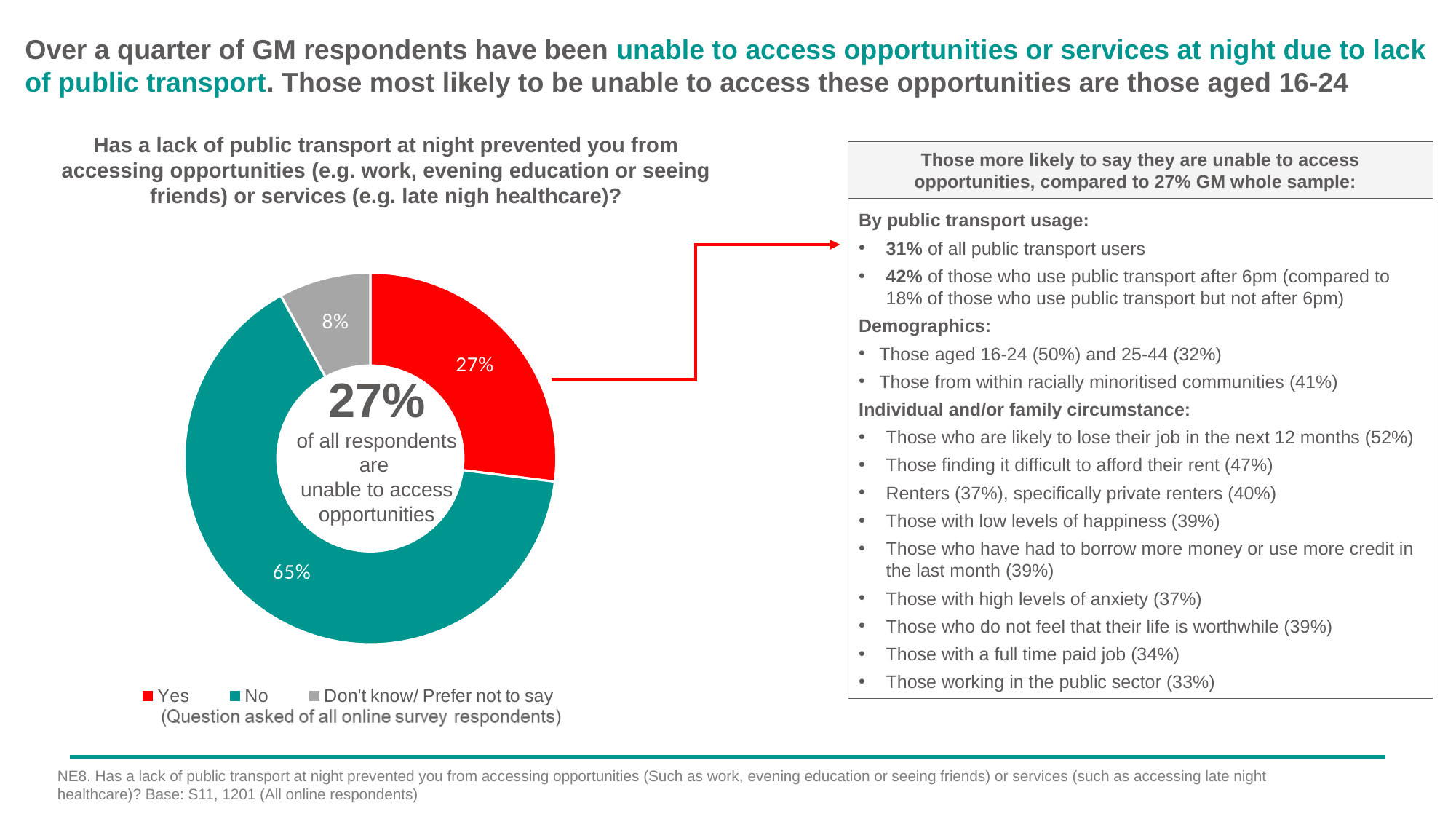
Which response category has the largest share of the chart? No What is the combined share of 'Yes' and 'No' responses? 92% What percentage of respondents answered 'Don't know/ Prefer not to say'? 8% Which is larger, the share for 'Yes' or the share for 'Don't know/ Prefer not to say'? Yes Which response category has the smallest share of the chart? Don't know/ Prefer not to say What kind of chart is shown on the slide? Doughnut (pie) chart What figure is printed in the centre of the doughnut chart? 27% What percentage of respondents answered 'No'? 65% What colour is used for the 'Yes' segment? Red How many categories does the chart show? 3 What is the difference in percentage points between the 'No' and 'Yes' shares? 38 What percentage of respondents answered 'Yes'? 27%